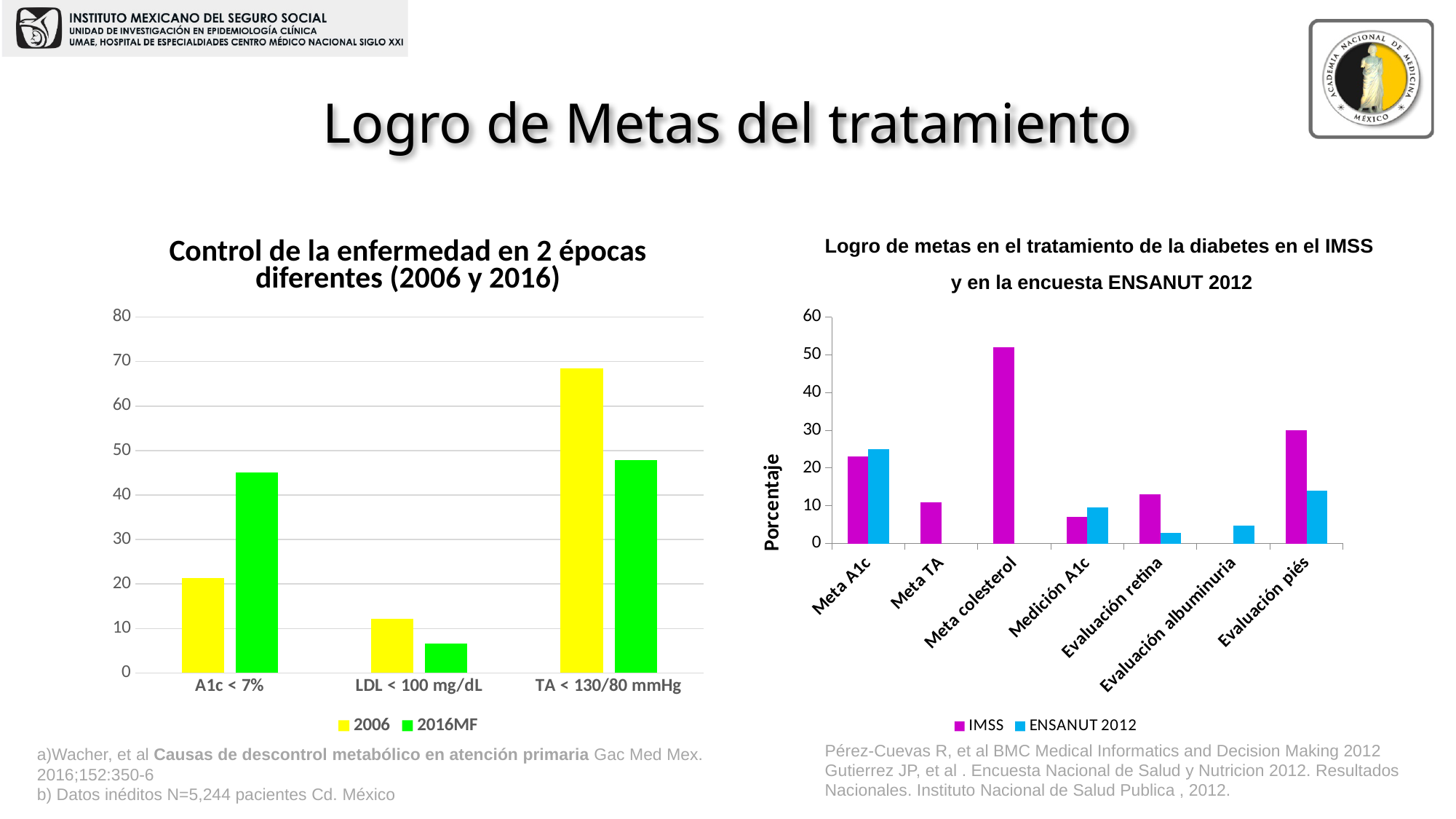
In the left chart (Control de la enfermedad en 2 épocas diferentes), for A1c < 7%, which series is larger, 2006 or 2016MF? 2016MF In the right chart (Logro de metas en el tratamiento de la diabetes en el IMSS y en la encuesta ENSANUT 2012), is the IMSS value for Meta colesterol greater or less than 50? greater In the right chart (Logro de metas en el tratamiento de la diabetes en el IMSS y en la encuesta ENSANUT 2012), how many categories are shown on the x axis? 7 In the right chart (Logro de metas en el tratamiento de la diabetes en el IMSS y en la encuesta ENSANUT 2012), which category has the highest IMSS value? Meta colesterol In the left chart (Control de la enfermedad en 2 épocas diferentes), which category has the highest 2006 value? TA < 130/80 mmHg In the left chart (Control de la enfermedad en 2 épocas diferentes), is the 2006 value for TA < 130/80 mmHg greater or less than 60? greater What kind of chart is the left chart titled "Control de la enfermedad en 2 épocas diferentes (2006 y 2016)"? Bar chart In the right chart (Logro de metas en el tratamiento de la diabetes en el IMSS y en la encuesta ENSANUT 2012), what is the label of the y axis? Porcentaje In the left chart (Control de la enfermedad en 2 épocas diferentes), how many categories are shown on the x axis? 3 In the left chart (Control de la enfermedad en 2 épocas diferentes), which category has the lowest 2016MF value? LDL < 100 mg/dL In the right chart (Logro de metas en el tratamiento de la diabetes en el IMSS y en la encuesta ENSANUT 2012), for Evaluación piés, which series is larger, IMSS or ENSANUT 2012? IMSS In the left chart (Control de la enfermedad en 2 épocas diferentes), how many series does the legend list? 2